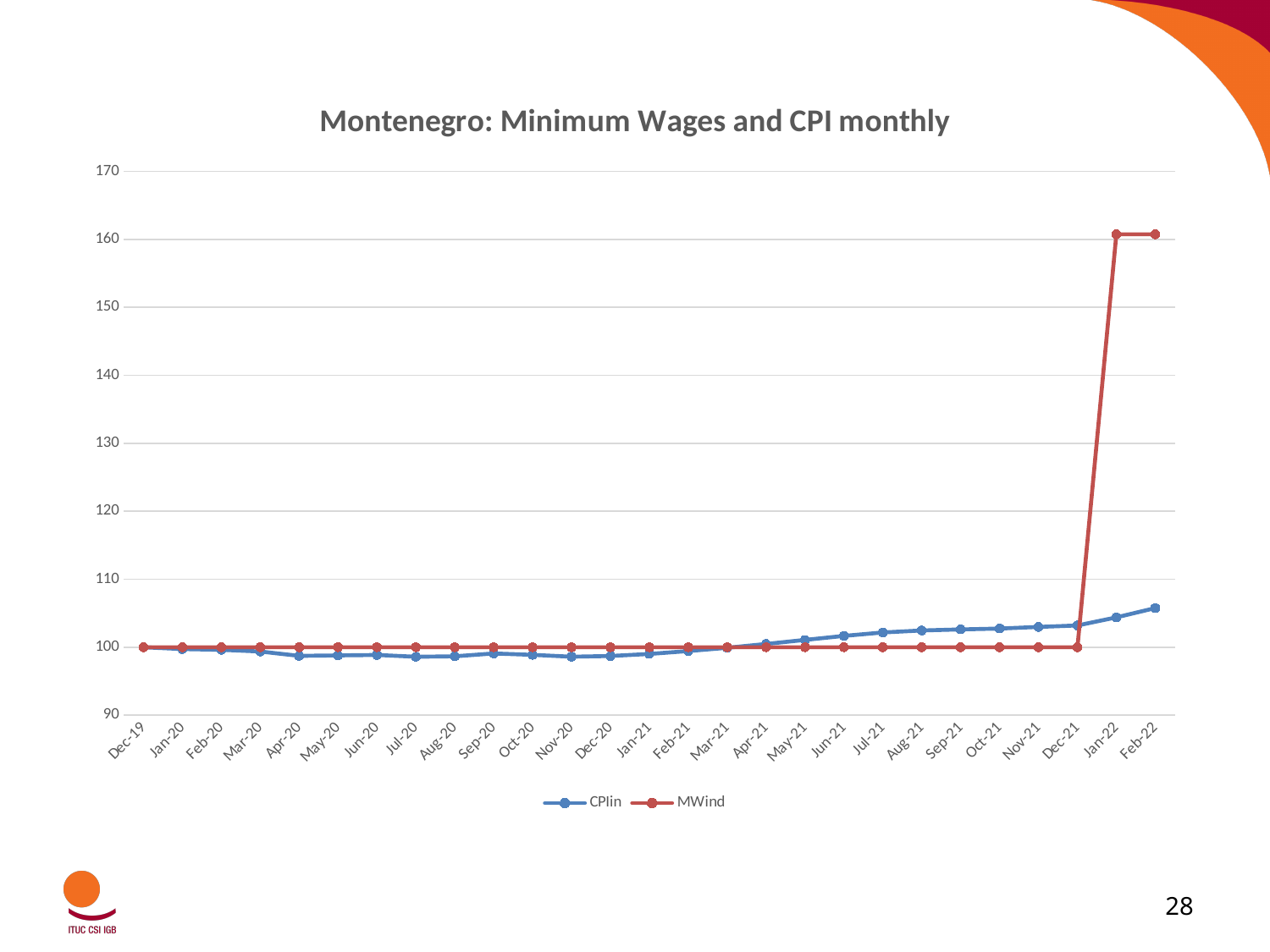
Is the value for MWind in Dec-21 greater or less than 110? less Is the value for CPIin in Feb-22 greater or less than 110? less How many series does the legend list? 2 Which series has the higher value in Feb-22, CPIin or MWind? MWind Which series has the higher value in Nov-21, CPIin or MWind? CPIin Does the CPIin series rise or fall between Mar-21 and Feb-22? rise Is the value for CPIin in Feb-22 greater or less than 100? greater How many months are plotted along the x axis? 27 What kind of chart is shown on the slide? line chart What are the names of the two series in the legend? CPIin and MWind What is the title of the chart? Montenegro: Minimum Wages and CPI monthly